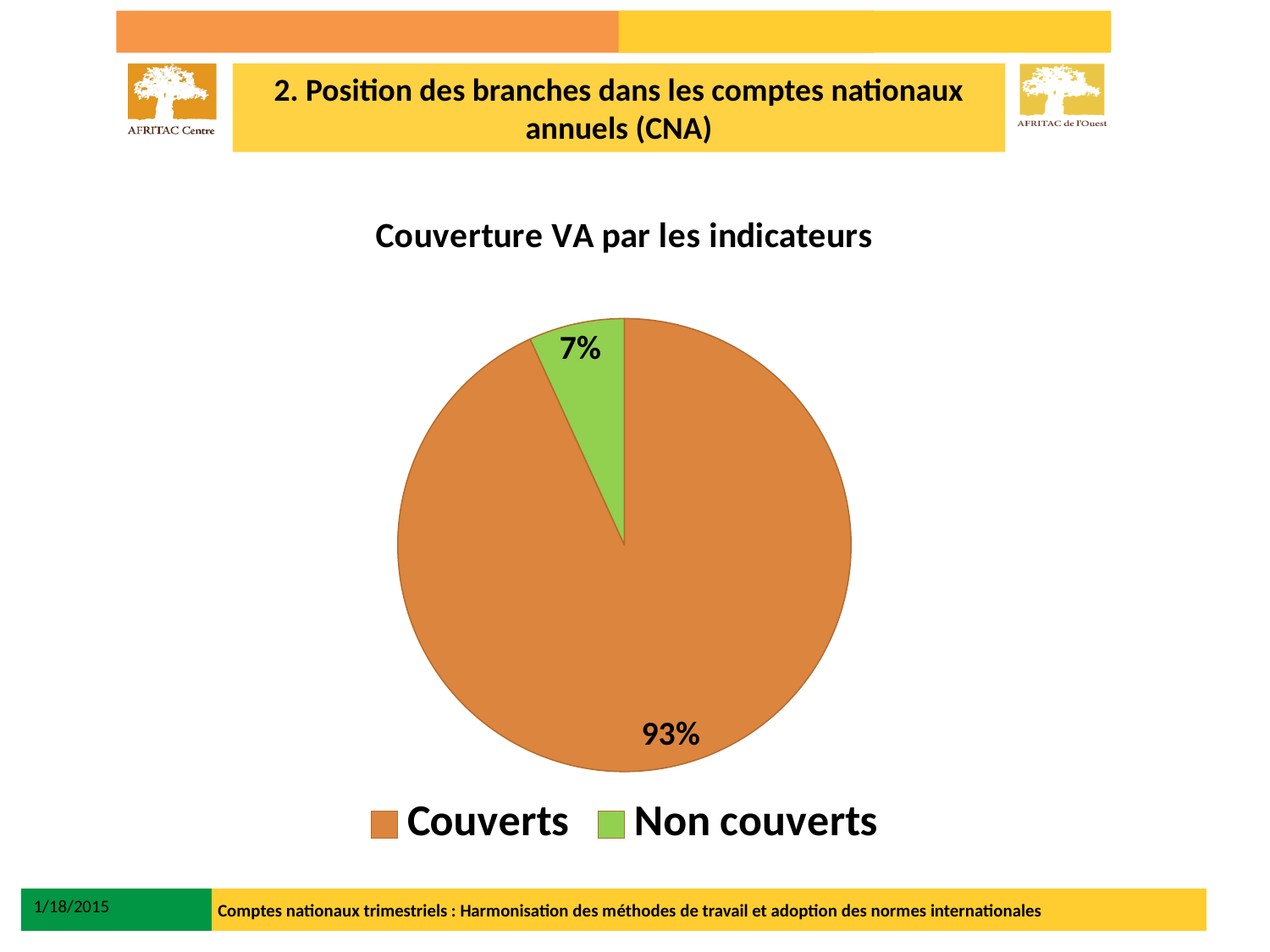
What colour is the 'Non couverts' slice? green What is the title of the chart? Couverture VA par les indicateurs How many entries does the legend list? 2 Which slice is the smallest? Non couverts What share of the pie is 'Non couverts'? 7% What share of the pie is 'Couverts'? 93% Which slice is the largest? Couverts What kind of chart is shown on the slide? pie chart What is the difference in percentage points between 'Couverts' and 'Non couverts'? 86 Which is larger, 'Couverts' or 'Non couverts'? Couverts How many slices does the pie chart have? 2